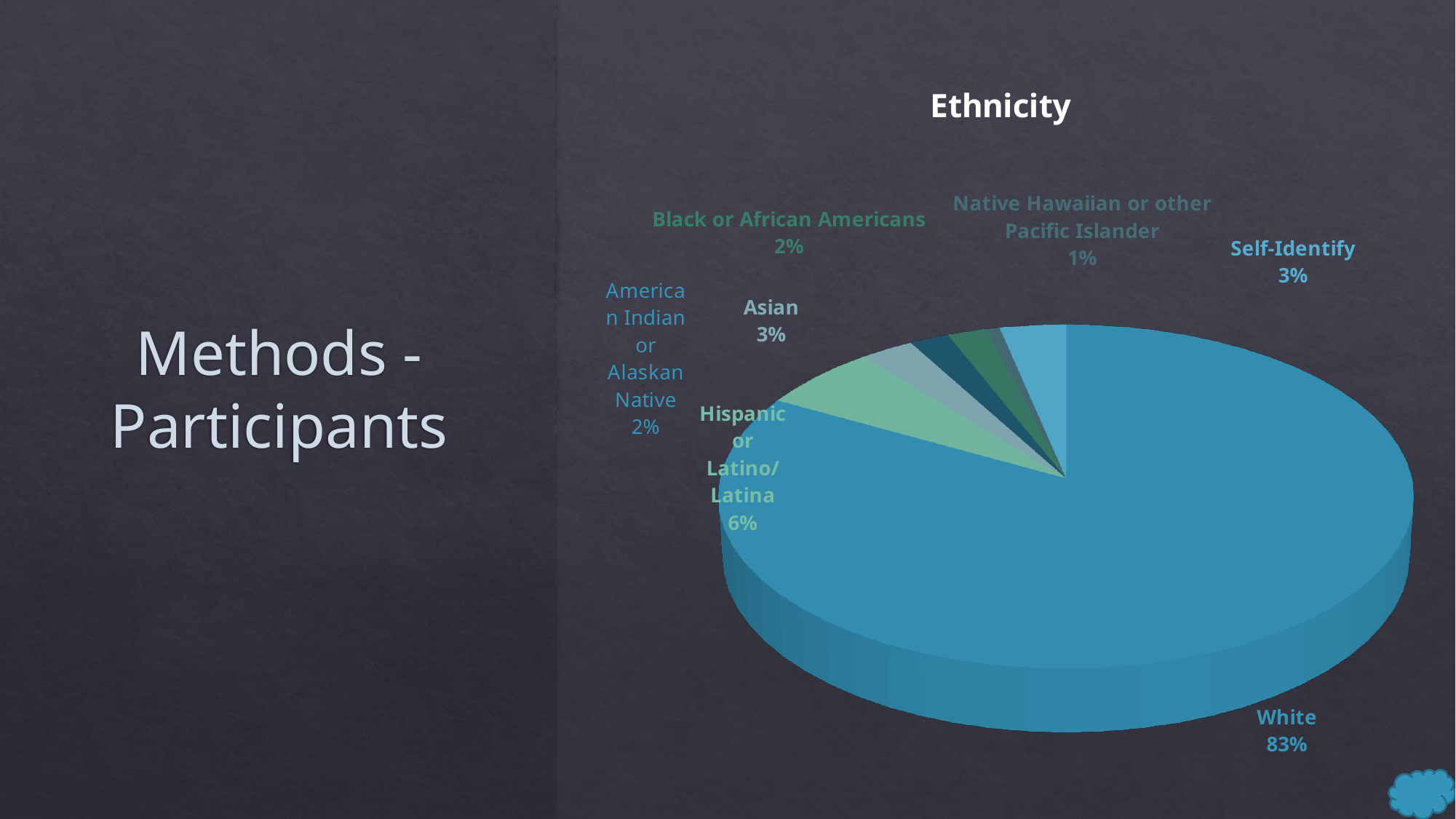
What percentage of participants are Black or African Americans? 2% What percentage of participants are Asian? 3% Which is larger, the share for Asian or the share for American Indian or Alaskan Native? Asian What percentage of participants are Native Hawaiian or other Pacific Islander? 1% What percentage of participants are White? 83% What is the difference in percentage points between White and Hispanic or Latino/Latina? 77% Which ethnicity category has the largest share of the pie? White What percentage of participants are Hispanic or Latino/Latina? 6% What kind of chart is shown on the slide? Pie chart What is the title of the chart? Ethnicity How many categories are shown in the pie chart? 7 Which ethnicity category has the smallest share of the pie? Native Hawaiian or other Pacific Islander